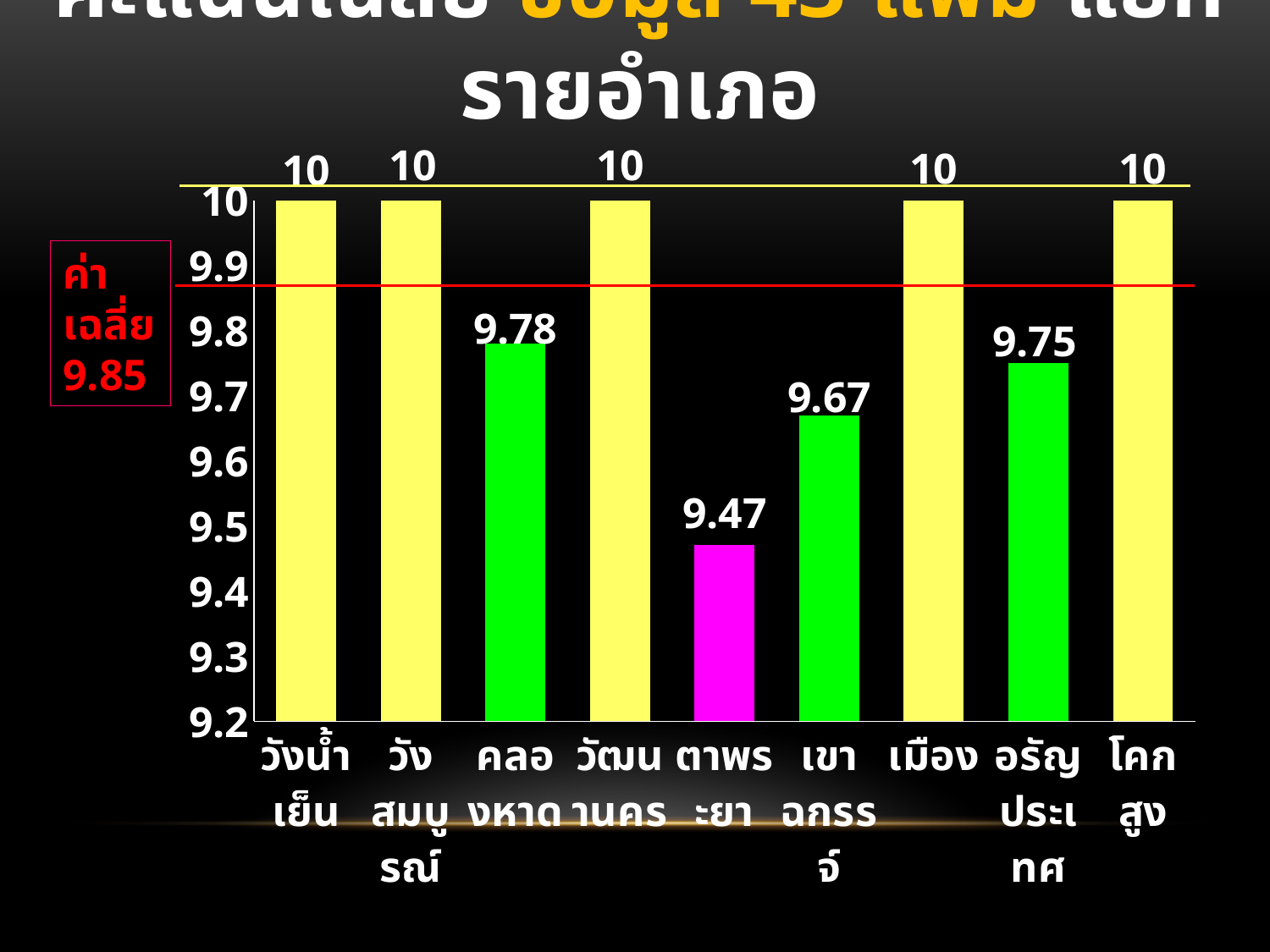
What is the value for อรัญประเทศ? 9.75 What is the value for เมือง? 10 What average value (ค่าเฉลี่ย) is marked by the red line on the chart? 9.85 Which category has the lowest value? ตาพระยา How many categories are shown on the x axis? 9 What kind of chart is shown on the slide? bar chart What is the value for คลองหาด? 9.78 What is the difference between the values for อรัญประเทศ and เขาฉกรรจ์? 0.08 What is the difference between the values for คลองหาด and ตาพระยา? 0.31 What is the value for เขาฉกรรจ์? 9.67 What is the value for ตาพระยา? 9.47 Which is larger, the value for คลองหาด or the value for อรัญประเทศ? คลองหาด